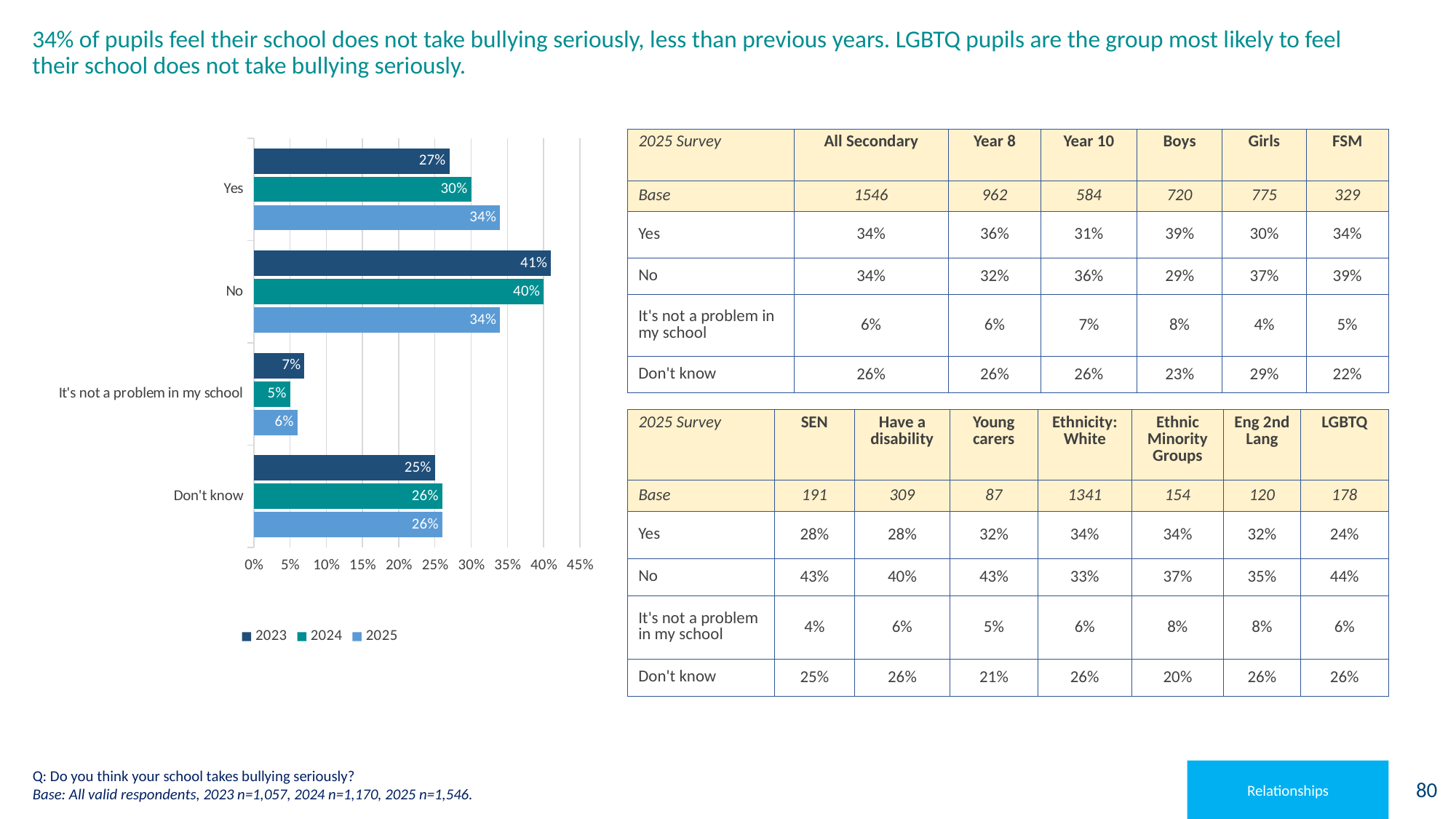
What percentage of pupils answered 'No' in 2023? 41% What percentage of pupils answered 'Yes' in 2025? 34% What is the value for 'It's not a problem in my school' in 2024? 5% What kind of chart is shown on the slide? Bar chart Which response category has the highest value for 2023? No How many response categories are shown on the chart? 4 What is the difference between the 'No' values for 2023 and 2025? 7% Which is larger, the 'Yes' value for 2023 or the 'Yes' value for 2024? 2024 Which response category has the lowest value for 2025? It's not a problem in my school How many series does the chart legend list? 3 Which year is shown in the lightest blue colour in the chart legend? 2025 Does the 'Yes' value rise or fall from 2023 to 2025? Rise